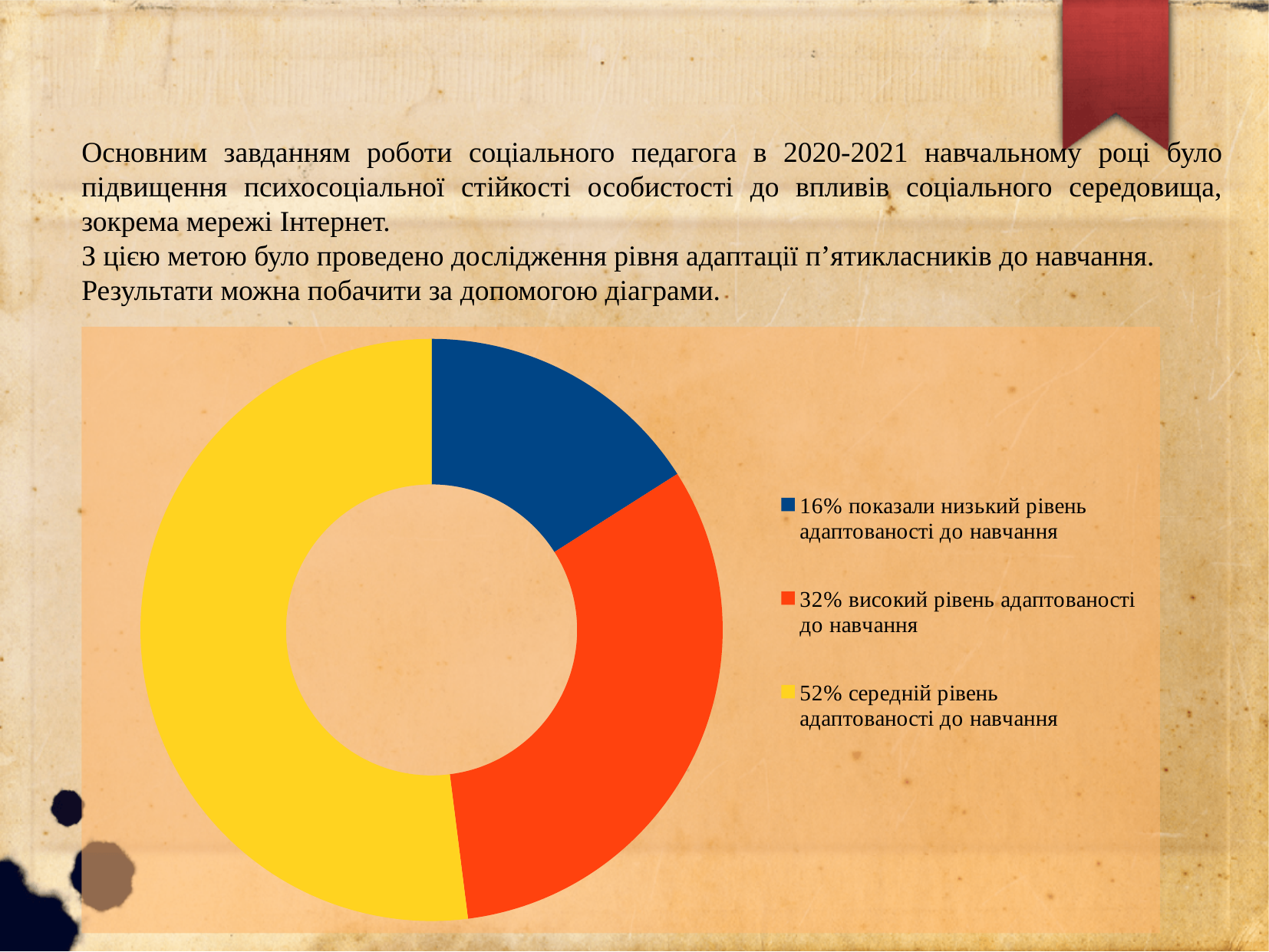
What is the difference in percentage points between the medium level (52%) and the high level (32%) shares? 20 percentage points What colour is the slice representing the low level of adaptation (16%)? Blue What share of pupils showed a medium level of adaptation to learning (середній рівень адаптованості)? 52% Which level of adaptation has the smallest share in the chart? низький рівень адаптованості до навчання (16%) Which level of adaptation has the largest share in the chart? середній рівень адаптованості до навчання (52%) How many entries does the legend of the chart list? 3 What kind of chart is shown on the slide? Doughnut chart What share of pupils showed a high level of adaptation to learning (високий рівень адаптованості)? 32% What colour is the slice representing the medium level of adaptation (52%)? Yellow How many slices does the doughnut chart have? 3 What share of pupils showed a low level of adaptation to learning (низький рівень адаптованості)? 16% Which is larger: the share with a high level of adaptation or the share with a low level of adaptation? High level (32%)